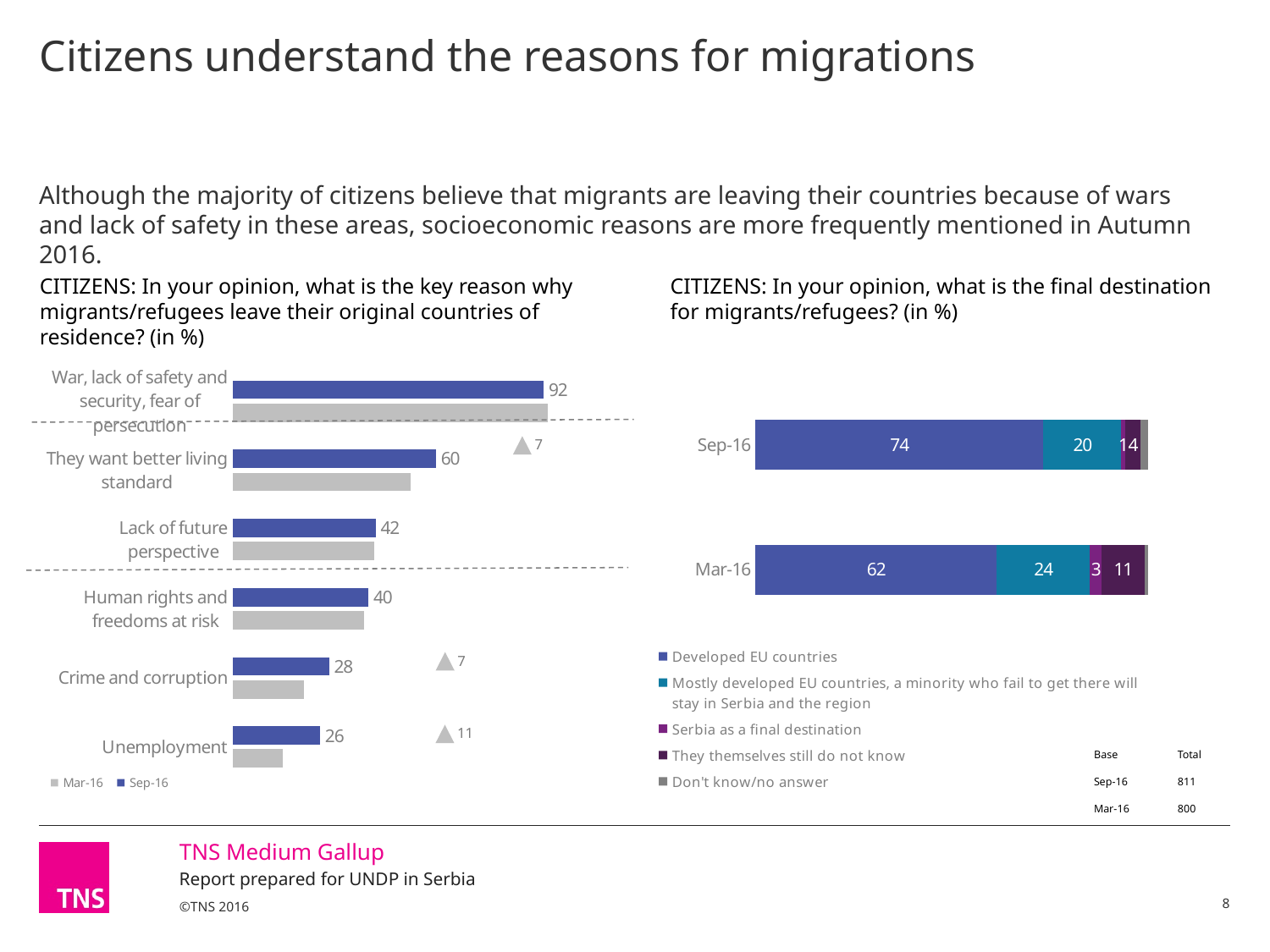
What kind of chart is the left chart on key reasons for leaving? Bar chart In the left chart on key reasons for leaving, what is the Sep-16 value for 'They want better living standard'? 60 In the right chart on final destination, what is the Sep-16 value for 'Developed EU countries'? 74 In the left chart on key reasons for leaving, what is the difference between the Sep-16 values for 'War, lack of safety and security, fear of persecution' and 'They want better living standard'? 32 In the left chart on key reasons for leaving, which category has the highest Sep-16 value? War, lack of safety and security, fear of persecution In the right chart on final destination, how many series does the legend list? 5 In the left chart on key reasons for leaving, how many categories are shown? 6 In the right chart on final destination, what is the difference between the Sep-16 and Mar-16 values for 'Developed EU countries'? 12 In the left chart on key reasons for leaving, which category has the lowest Sep-16 value? Unemployment In the left chart on key reasons for leaving, what is the Sep-16 value for 'War, lack of safety and security, fear of persecution'? 92 In the left chart on key reasons for leaving, how many series does the legend list? 2 In the right chart on final destination, what is the Mar-16 value for 'They themselves still do not know'? 11